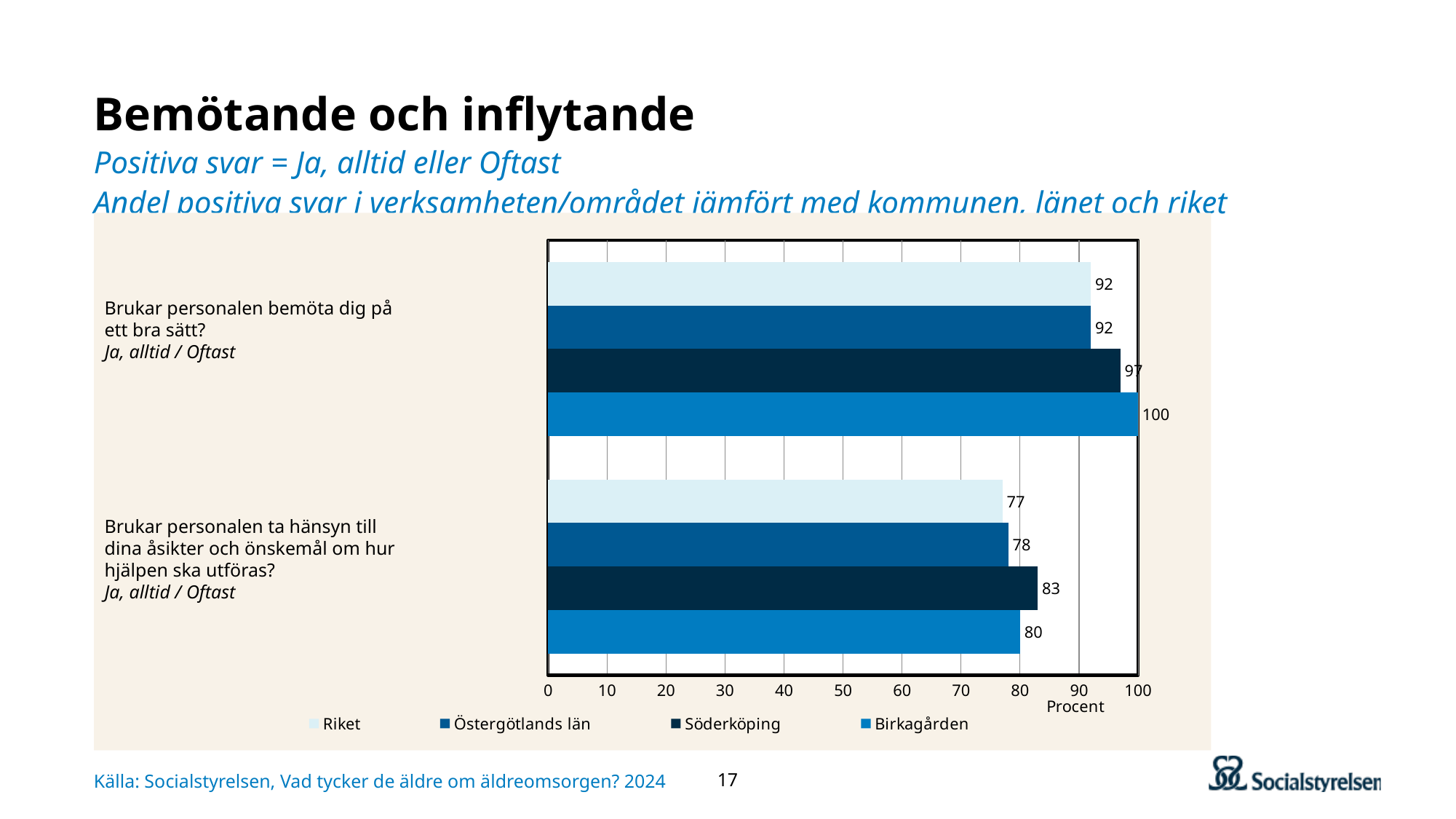
What unit is shown on the horizontal axis of the chart? Procent How many series does the legend list? 4 What kind of chart is shown on the slide? Bar chart What is the value for Söderköping on the question "Brukar personalen ta hänsyn till dina åsikter och önskemål om hur hjälpen ska utföras?"? 83 Which series has the highest value on the question "Brukar personalen bemöta dig på ett bra sätt?"? Birkagården What is the value for Birkagården on the question "Brukar personalen bemöta dig på ett bra sätt?"? 100 Which series has the lowest value on the question "Brukar personalen ta hänsyn till dina åsikter och önskemål om hur hjälpen ska utföras?"? Riket Which is larger on the question "Brukar personalen ta hänsyn till dina åsikter och önskemål om hur hjälpen ska utföras?": Söderköping or Östergötlands län? Söderköping What is the value for Riket on the question "Brukar personalen ta hänsyn till dina åsikter och önskemål om hur hjälpen ska utföras?"? 77 What is the value for Östergötlands län on the question "Brukar personalen bemöta dig på ett bra sätt?"? 92 What is the difference between the Söderköping value and the Birkagården value on the question "Brukar personalen ta hänsyn till dina åsikter och önskemål om hur hjälpen ska utföras?"? 3 What is the difference between the Birkagården value and the Riket value on the question "Brukar personalen bemöta dig på ett bra sätt?"? 8